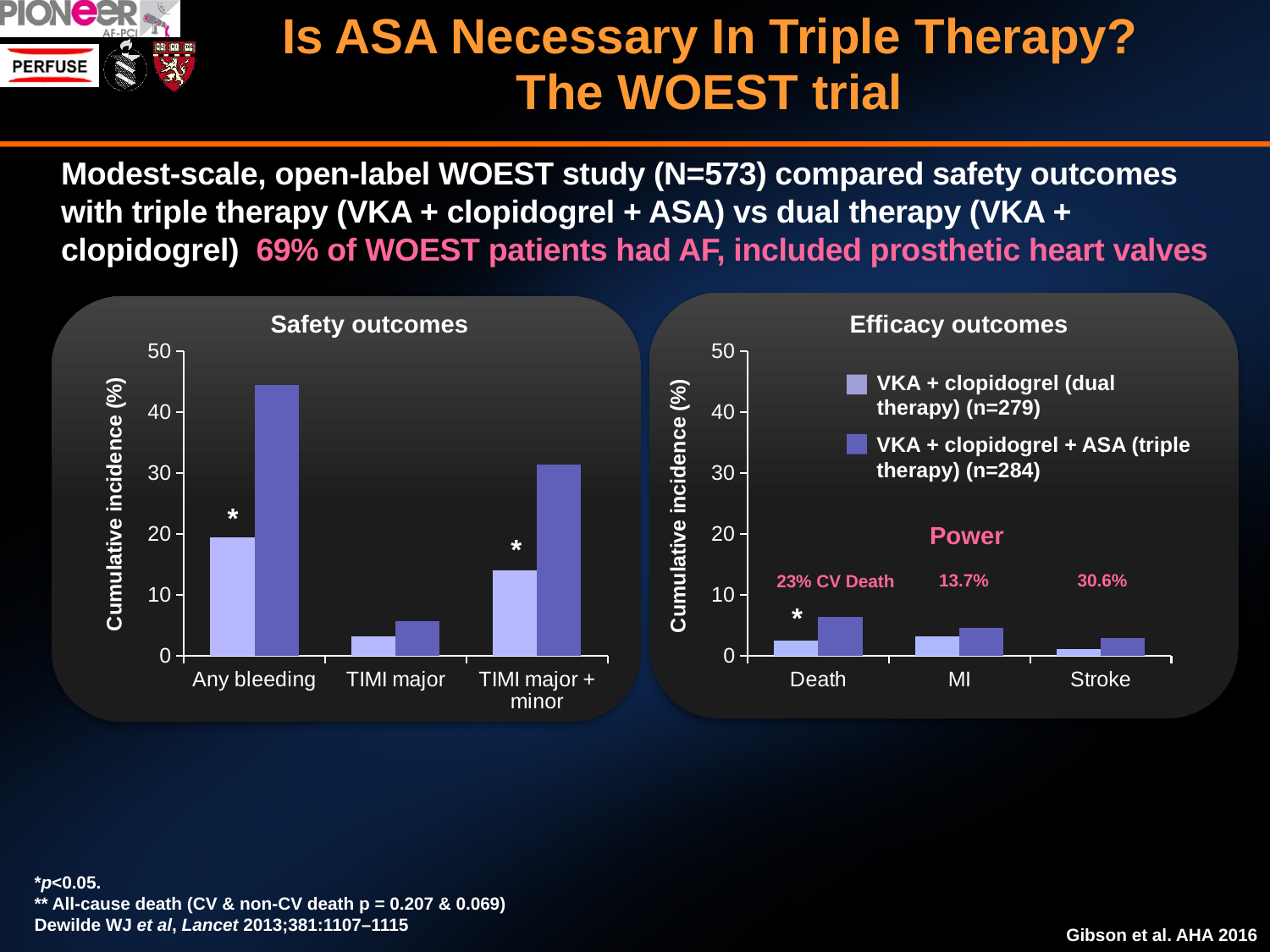
In the Safety outcomes chart, which category has the lowest bars? TIMI major In the Efficacy outcomes chart, which category has the highest bar? Death In the Efficacy outcomes chart, is the triple therapy value for Death greater or less than 10? less In the Safety outcomes chart, which is larger for Any bleeding: the dual therapy bar or the triple therapy bar? triple therapy In the Safety outcomes chart, is the dual therapy value for TIMI major + minor greater or less than 20? less In the Safety outcomes chart, is the triple therapy value for Any bleeding greater or less than 40? greater What is the y-axis label on the Efficacy outcomes chart? Cumulative incidence (%) How many categories are shown on the x axis of the Safety outcomes chart? 3 What kind of chart is the Safety outcomes chart? bar chart How many series does the legend on the Efficacy outcomes chart list? 2 In the Efficacy outcomes chart, which is larger for Stroke: the dual therapy bar or the triple therapy bar? triple therapy In the Safety outcomes chart, which category has the highest bar? Any bleeding